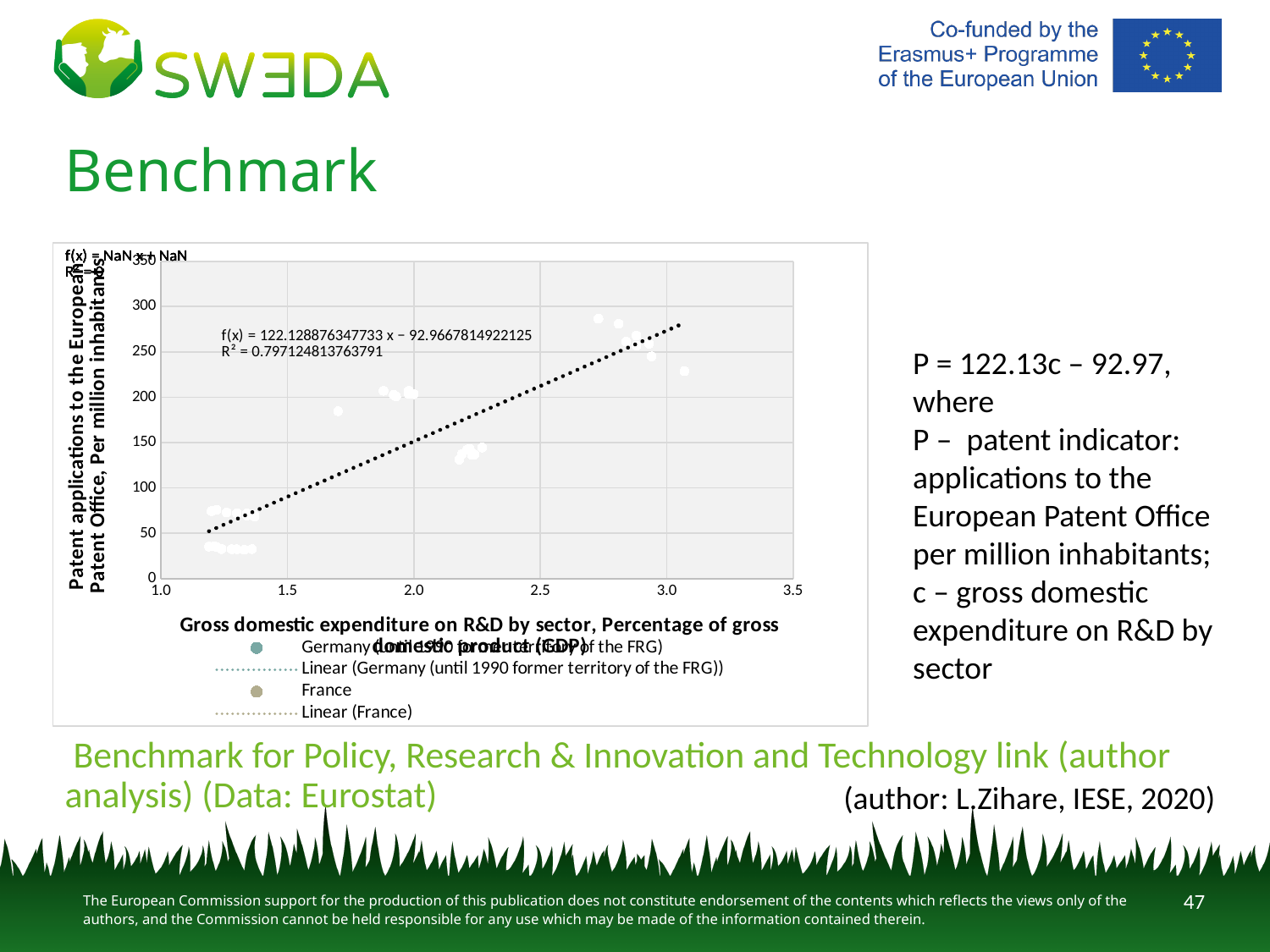
What is the maximum value shown on the chart's vertical axis? 350 What is the title of the chart's horizontal axis? Gross domestic expenditure on R&D by sector, Percentage of gross domestic product (GDP) What is the R² value printed on the chart for the fitted trendline? 0.797124813763791 What is the equation of the fitted trendline printed on the chart? f(x) = 122.128876347733 x − 92.9667814922125 Which two countries are plotted as data series in the chart? Germany and France What is the maximum value shown on the chart's horizontal axis? 3.5 What is the minimum value shown on the chart's horizontal axis? 1.0 Do the plotted values rise or fall as the x-axis value increases? Rise How many entries does the chart legend list? 4 What is the title of the chart's vertical axis? Patent applications to the European Patent Office, Per million inhabitants What kind of chart is shown on the slide? Scatter chart